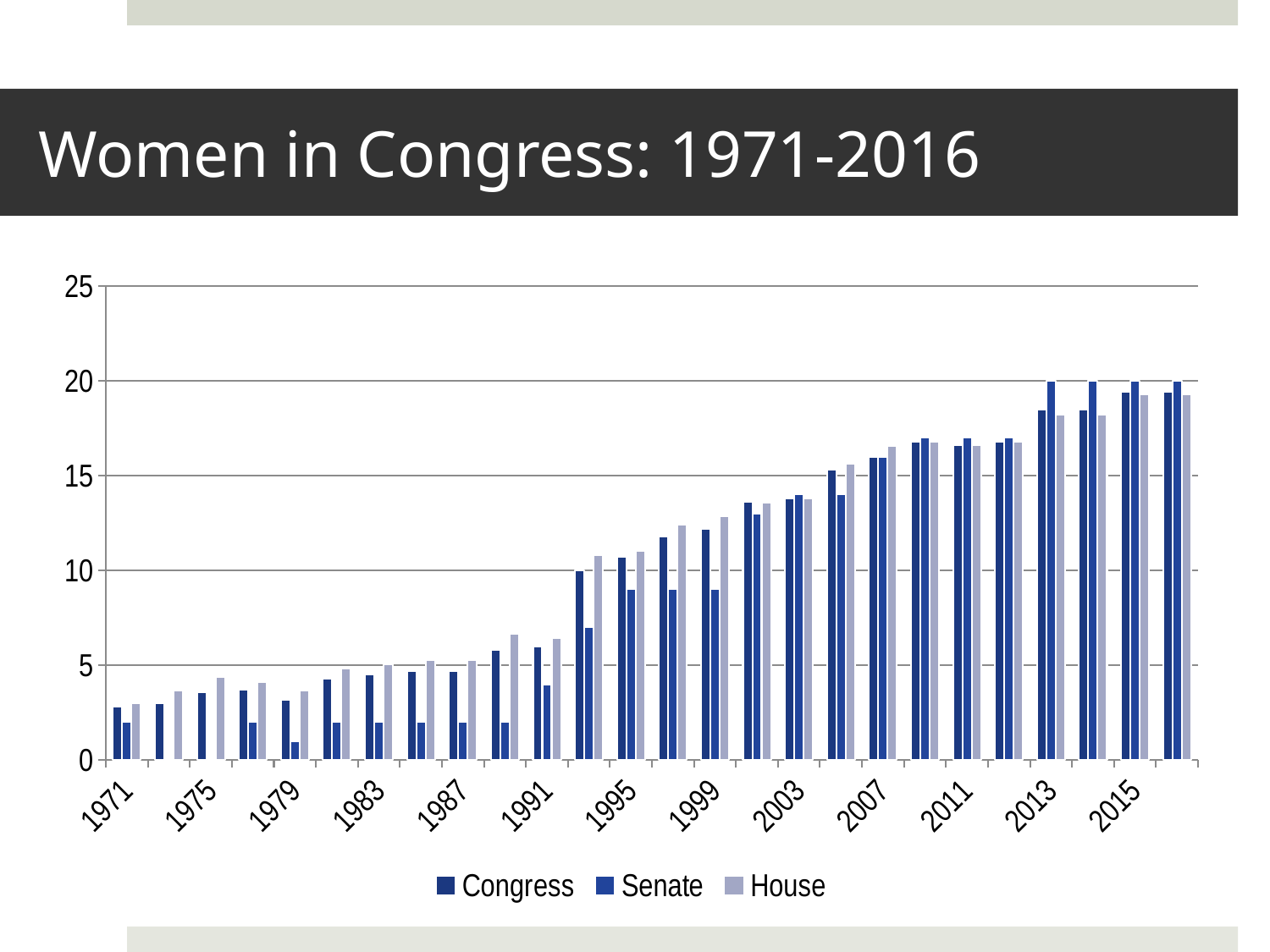
Is the value for Congress in 2013 greater or less than 20? less Which is larger in 1995, the Senate value or the House value? House Is the value for Senate in 1999 greater or less than 10? less Is the value for House in 1991 greater or less than 5? greater Do the Congress values generally rise or fall from 1971 to 2015? rise How many series does the legend list? 3 Which series has the highest value in 2013? Senate What kind of chart is shown on the slide? bar chart What is the title of the chart? Women in Congress: 1971-2016 Which series does the legend list last? House